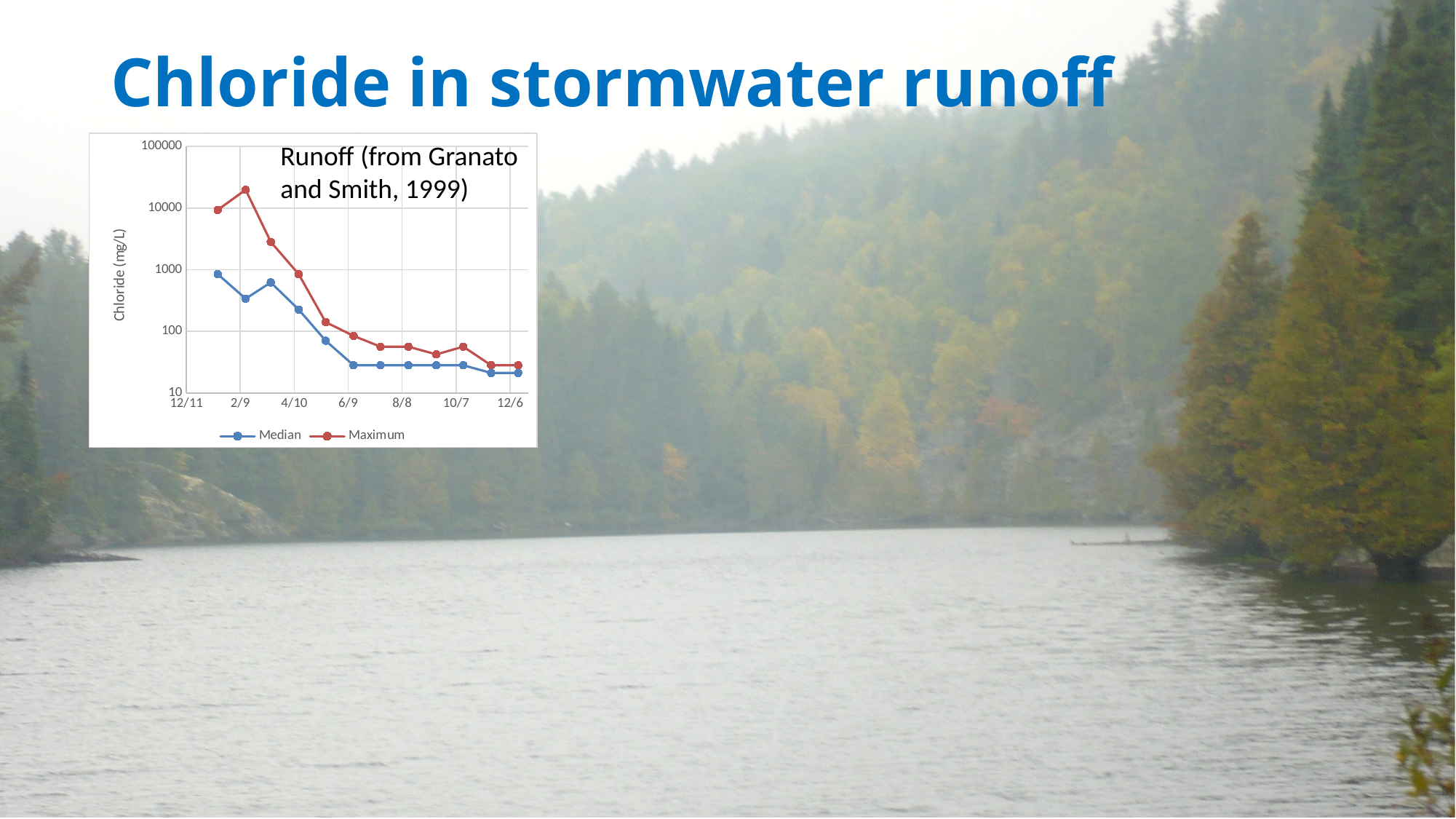
Do the Maximum values generally rise or fall from 2/9 to 12/6? Fall What is the label on the chart's vertical axis? Chloride (mg/L) Is the Maximum value at 8/8 greater or less than 100? less Is the Median value at 12/6 greater or less than 100? less Is the Median value at 2/9 greater or less than 1000? less What are the two series named in the chart's legend? Median and Maximum How many series does the chart's legend list? 2 What kind of chart is shown on the slide? Line chart At 2/9, which series has the larger value, Median or Maximum? Maximum